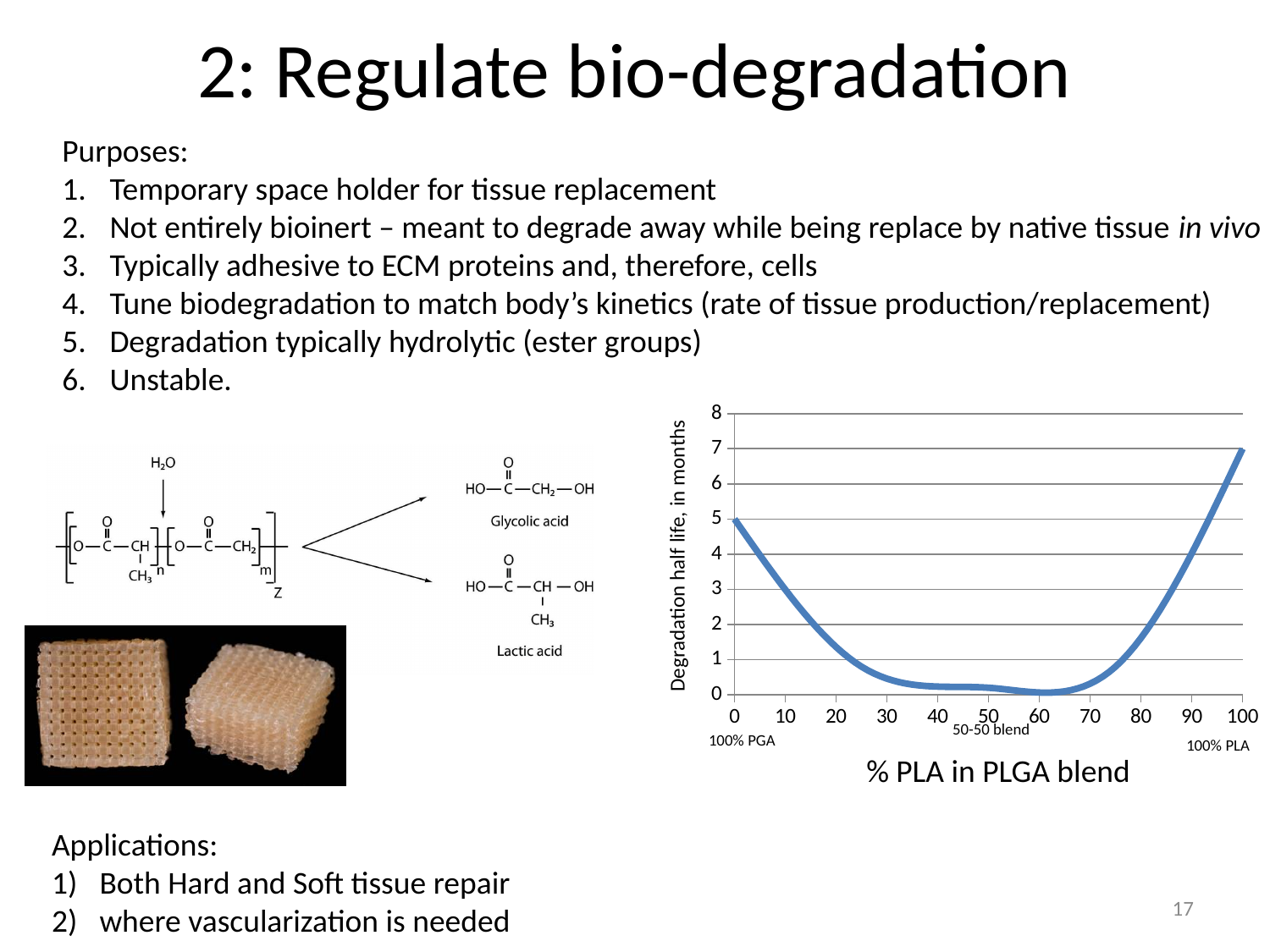
Is the degradation half life at 50% PLA greater or less than 1 month? less What kind of chart is shown on the slide? line chart What is the label of the y axis of the chart? Degradation half life, in months Is the degradation half life at 0% PLA greater or less than 4 months? greater Does the degradation half life rise or fall as % PLA increases from 0 to 50? fall Is the degradation half life at 100% PLA greater or less than 6 months? greater Which has the shorter degradation half life, the 50-50 blend or 100% PGA? 50-50 blend What is the label of the x axis of the chart? % PLA in PLGA blend Does the degradation half life rise or fall as % PLA increases from 70 to 100? rise Which has the longer degradation half life, 100% PGA or 100% PLA? 100% PLA